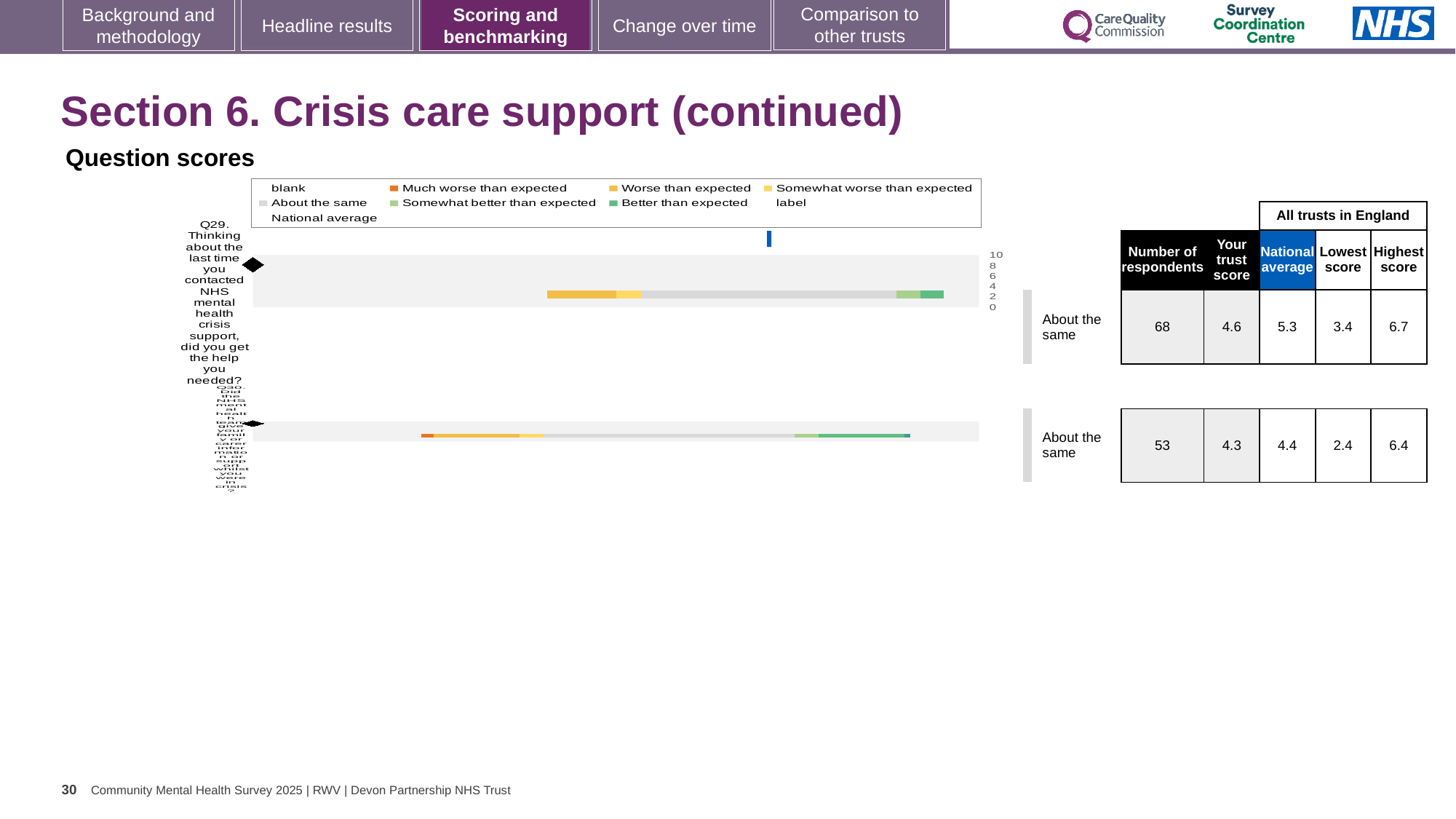
Which question has the higher trust score, Q29 or the second question (Q30)? Q29 What is the lowest score among all trusts in England for the second question (Q30) in the chart? 2.4 What is the trust's score for Q29 (did you get the help you needed?)? 4.6 What is the difference between the national average and the trust's score for Q29 (did you get the help you needed?)? 0.7 What kind of chart is used to show the question scores on this slide? bar chart What benchmarking category is the trust's score for Q29 (did you get the help you needed?) placed in? About the same What is the difference between the highest and lowest scores among all trusts in England for the second question (Q30)? 4.0 What is the number of respondents for the second question (Q30) in the chart? 53 What is the national average for Q29 (did you get the help you needed?)? 5.3 How many questions are plotted in the question scores chart? 2 What is the highest score among all trusts in England for Q29 (did you get the help you needed?)? 6.7 What is the number of respondents for Q29 (Thinking about the last time you contacted NHS mental health crisis support, did you get the help you needed?)? 68